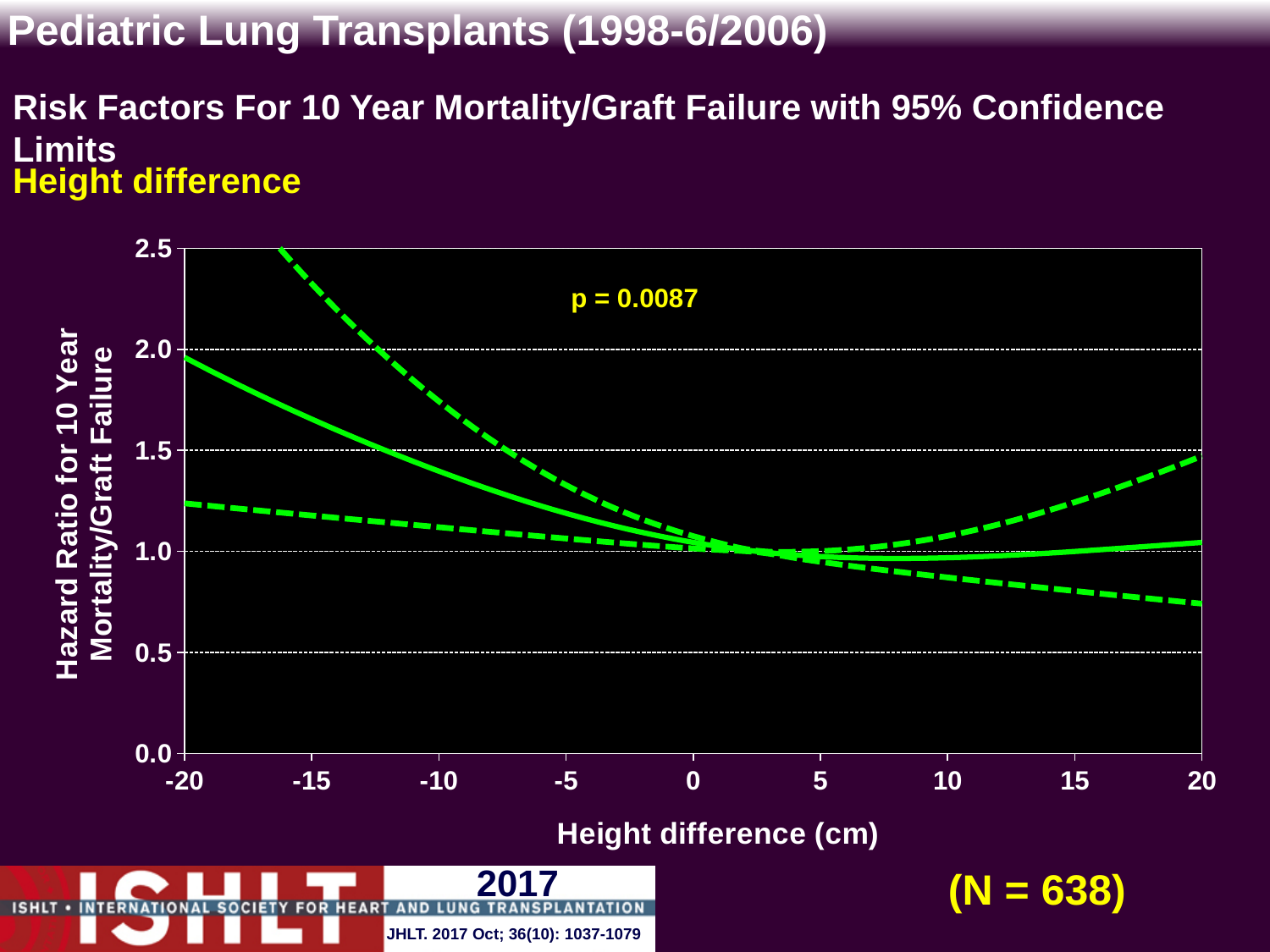
Is the lower dashed confidence limit at a height difference of 20 cm greater or less than 1.0? less How many tick labels are shown on the x axis? 9 What kind of chart is shown on the slide? line chart Is the solid hazard ratio line at a height difference of -20 cm greater or less than 1.5? greater How many lines are plotted on the chart? 3 Does the solid hazard ratio line rise or fall as height difference goes from -20 cm to 0 cm? fall What is the sample size (N) shown on the slide? N = 638 Is the lower dashed confidence limit at a height difference of 20 cm greater or less than 0.5? greater What is the p-value printed on the chart? p = 0.0087 Is the solid hazard ratio line higher at a height difference of -20 cm or at 20 cm? -20 cm